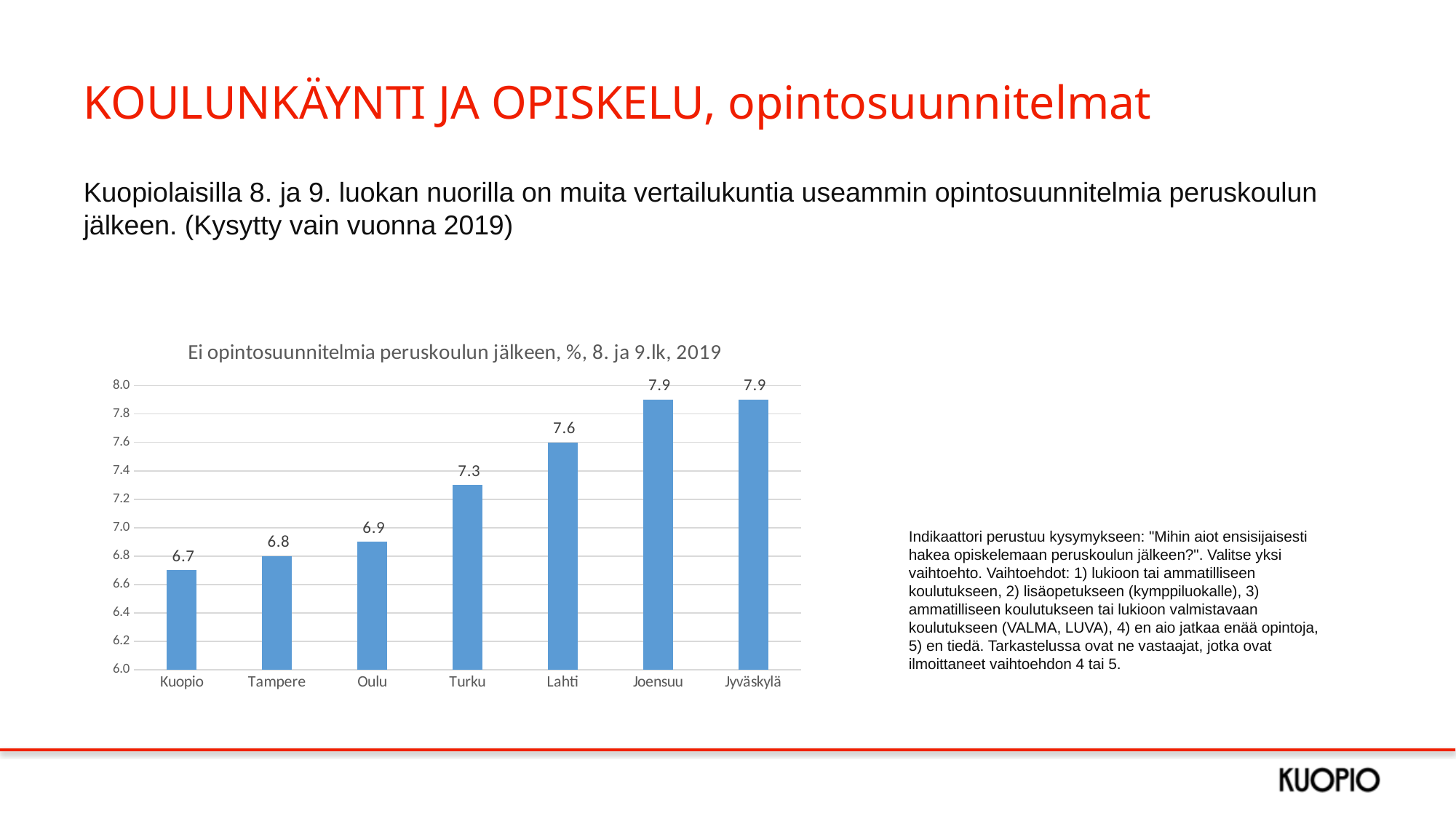
What is the difference between the values for Lahti and Oulu? 0.7 Is the value for Oulu greater or less than 7.0? less What is the value for Kuopio? 6.7 What kind of chart is shown? bar chart Which city has the lowest value? Kuopio What is the difference between the values for Joensuu and Kuopio? 1.2 Do the values rise or fall from Kuopio to Jyväskylä along the x axis? rise What is the value for Lahti? 7.6 How many cities are shown on the x axis? 7 Which is larger, the value for Tampere or the value for Turku? Turku What is the title of the chart? Ei opintosuunnitelmia peruskoulun jälkeen, %, 8. ja 9.lk, 2019 What is the value for Turku? 7.3